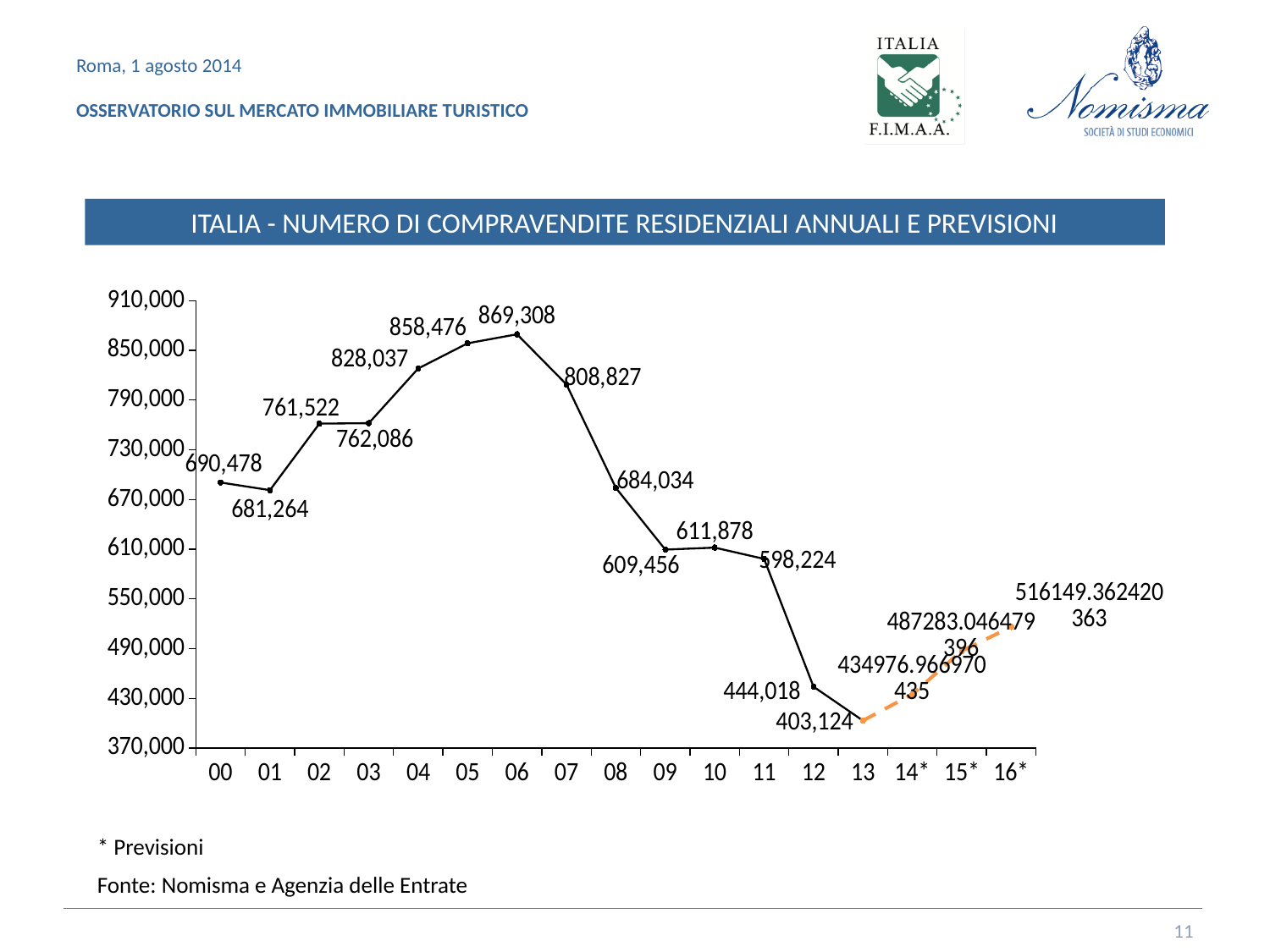
What kind of chart is shown on the slide? line chart Do the values rise or fall from 06 to 13? fall What is the value plotted for 00? 690,478 Which year has the lowest value on the chart? 13 What is the difference between the values for 12 and 13? 40,894 Which year has the highest number of residential sales? 06 Is the forecast value for 16* greater or less than 490,000? greater Which is larger, the value for 08 or the value for 12? 08 What is the difference between the values for 06 and 13? 466,184 What is the value plotted for 13? 403,124 What is the number of residential sales for 06? 869,308 How many years are plotted on the x axis? 17